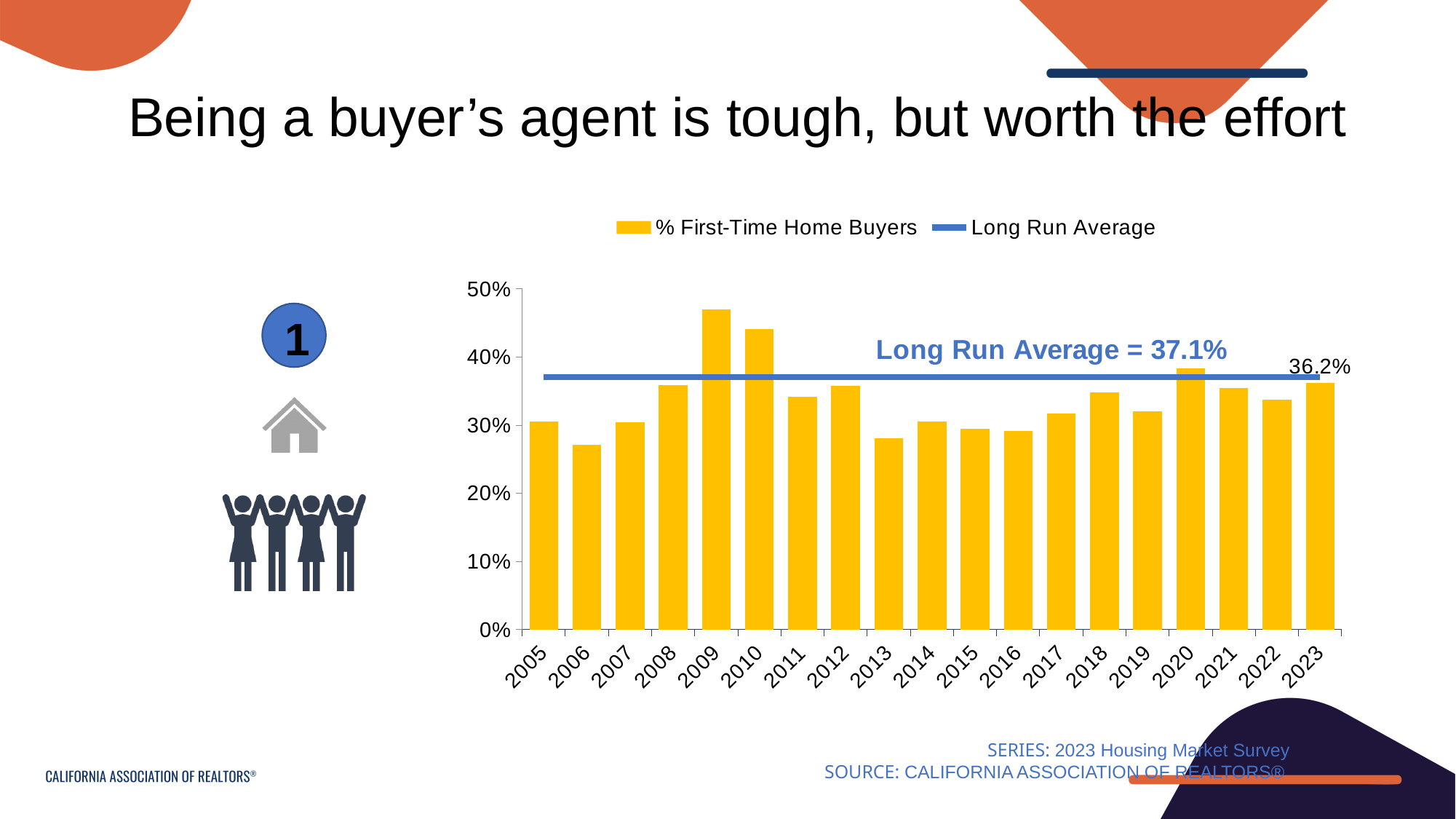
What is the Long Run Average shown on the chart? 37.1% What is the value for 2023 in the % First-Time Home Buyers series? 36.2% Which year has a higher share of first-time home buyers, 2008 or 2013? 2008 Is the value for 2009 greater or less than 40%? greater By how many percentage points is the 2023 value below the Long Run Average? 0.9 percentage points Do the values rise or fall from 2020 to 2022? Fall Which year has a higher share of first-time home buyers, 2009 or 2010? 2009 Which year has the highest share of first-time home buyers? 2009 How many series does the legend list? 2 What kind of chart is shown on the slide? Combination bar and line chart Is the value for 2006 greater or less than 30%? less How many years are shown on the x axis? 19